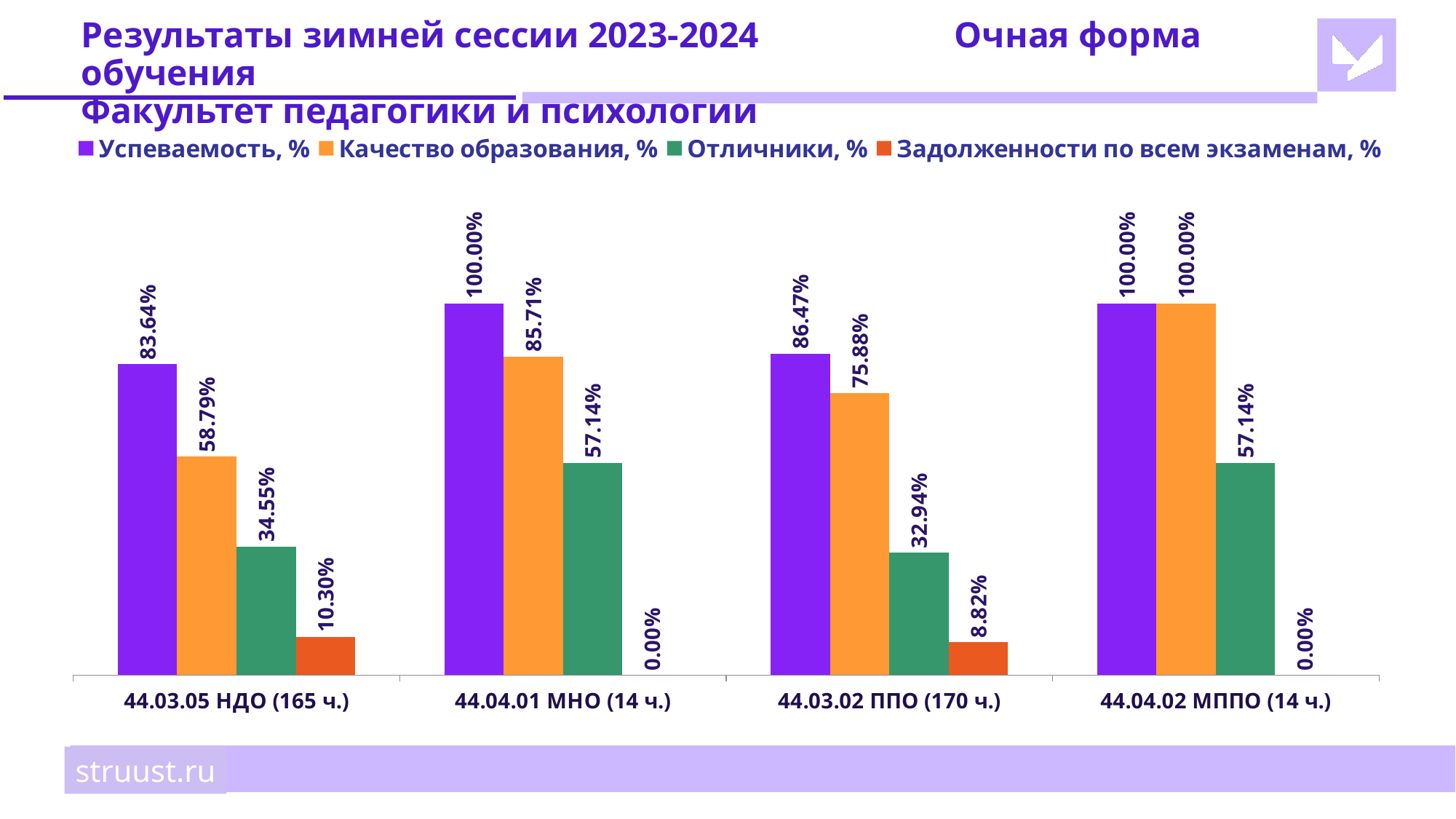
What is the value of Качество образования, % for 44.03.02 ППО (170 ч.)? 75.88% Which colour represents Качество образования, % in the legend? Orange What is the value of Успеваемость, % for 44.03.05 НДО (165 ч.)? 83.64% What kind of chart is shown on the slide? Bar chart What is the value of Отличники, % for 44.04.01 МНО (14 ч.)? 57.14% Which is larger: Отличники, % for 44.03.05 НДО (165 ч.) or for 44.03.02 ППО (170 ч.)? 44.03.05 НДО (165 ч.) Which category has the lowest value for Успеваемость, %? 44.03.05 НДО (165 ч.) What is the value of Задолженности по всем экзаменам, % for 44.03.05 НДО (165 ч.)? 10.30% What is the difference between Успеваемость, % for 44.03.02 ППО (170 ч.) and 44.03.05 НДО (165 ч.)? 2.83% How many categories are shown on the x axis of the chart? 4 How many series does the legend list? 4 Which category has the highest value for Задолженности по всем экзаменам, %? 44.03.05 НДО (165 ч.)